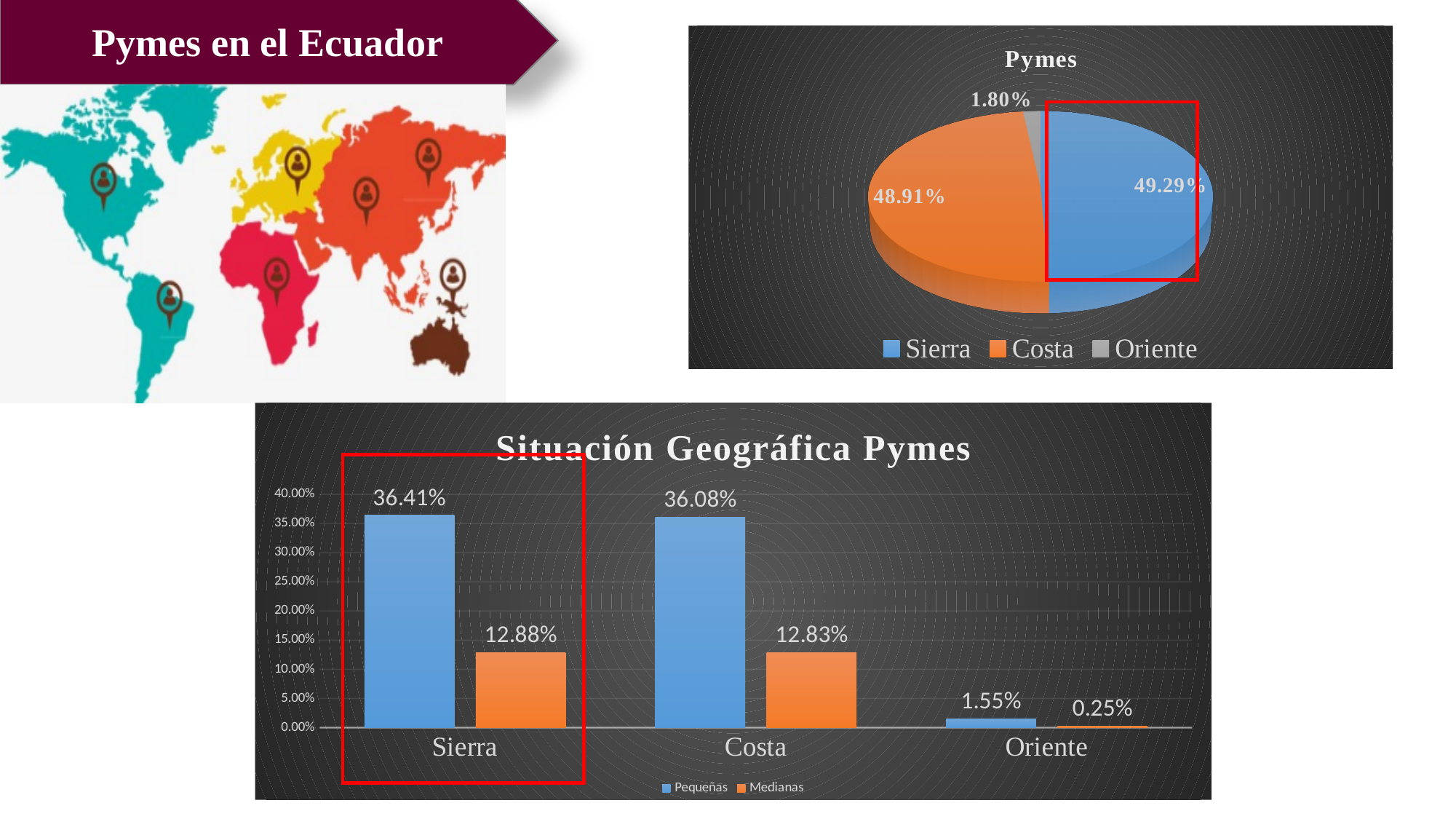
In the pie chart titled "Pymes", what share does Sierra have? 49.29% What kind of chart is the chart titled "Situación Geográfica Pymes"? Bar chart In the chart titled "Situación Geográfica Pymes", which region has the highest value for Pequeñas? Sierra In the chart titled "Situación Geográfica Pymes", what is the value for Medianas in Oriente? 0.25% In the chart titled "Situación Geográfica Pymes", what is the difference between Pequeñas and Medianas in Sierra? 23.53% In the chart titled "Situación Geográfica Pymes", how many series does the legend list? 2 In the pie chart titled "Pymes", what share does Oriente have? 1.80% In the chart titled "Situación Geográfica Pymes", what is the value for Medianas in Sierra? 12.88% What kind of chart is the chart titled "Pymes"? Pie chart In the chart titled "Situación Geográfica Pymes", what is the value for Pequeñas in Costa? 36.08% In the pie chart titled "Pymes", which region has the smallest slice? Oriente In the pie chart titled "Pymes", how many slices are there? 3